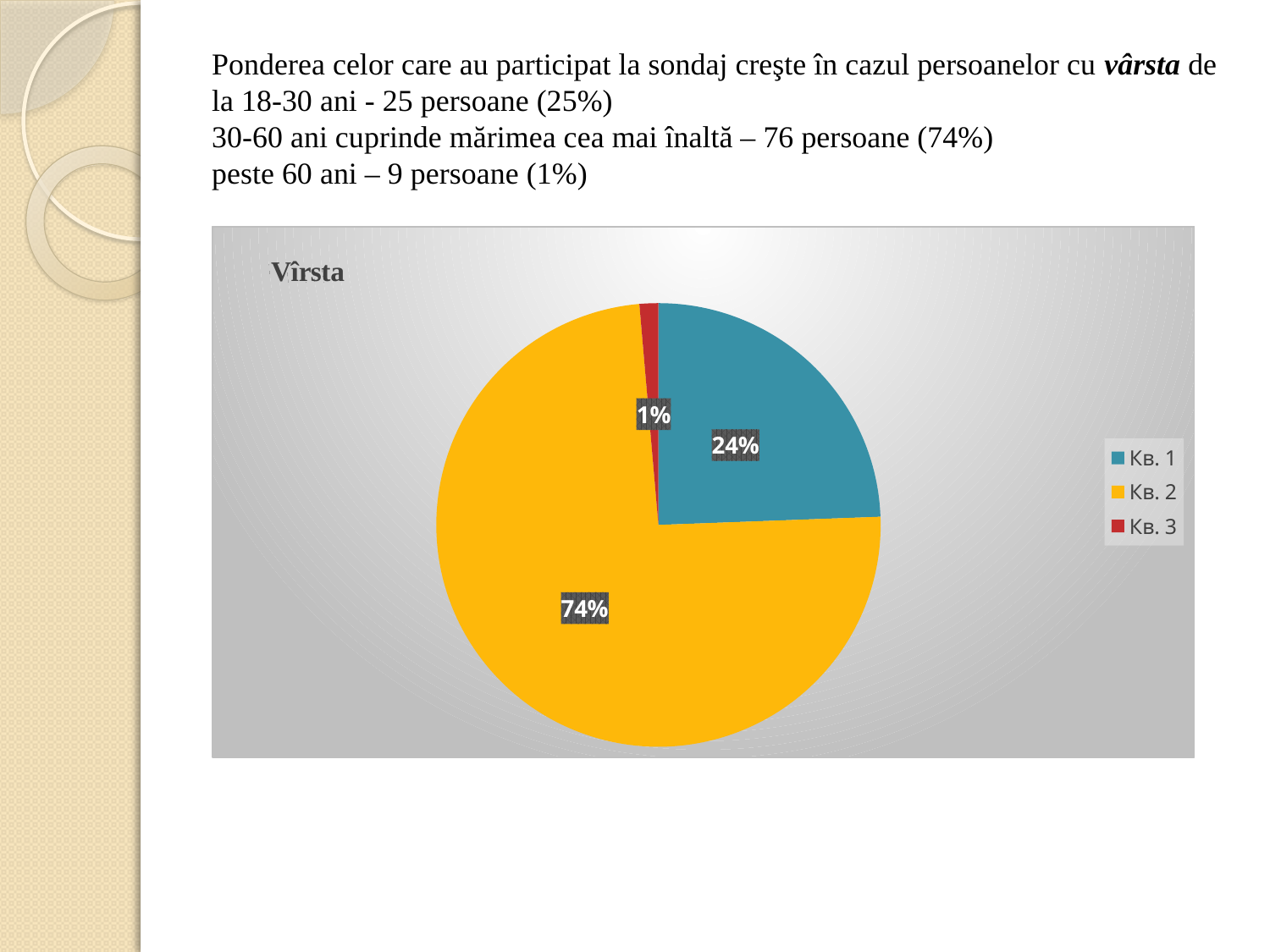
Which slice is larger, Кв. 1 or Кв. 3? Кв. 1 What is the difference in percentage points between the Кв. 2 slice and the Кв. 1 slice? 50 How many slices does the pie chart have? 3 What percentage does the Кв. 2 slice show? 74% What kind of chart is shown on the slide? pie chart Which slice is the smallest in the pie chart? Кв. 3 Which slice is the largest in the pie chart? Кв. 2 What colour is the Кв. 2 slice? yellow How many entries does the legend list? 3 What is the title of the chart? Vîrsta What percentage does the Кв. 3 slice show? 1% What percentage does the Кв. 1 slice show? 24%